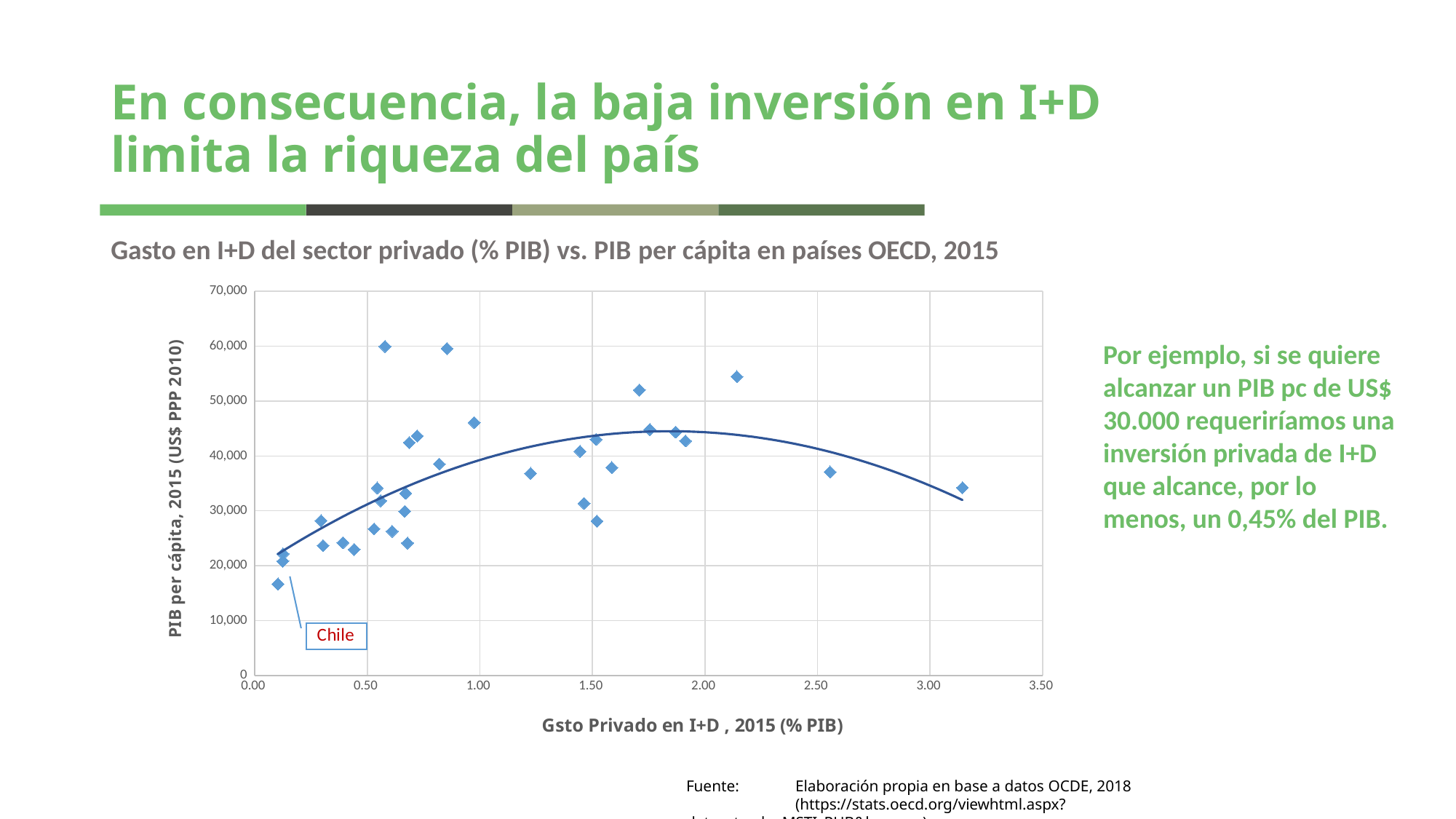
Which country is labeled on the chart? Chile Does the fitted trend line rise or fall as private R&D spending increases from 2.50 to 3.00? falls What kind of chart is shown on the slide? scatter chart What is the title of the chart? Gasto en I+D del sector privado (% PIB) vs. PIB per cápita en países OECD, 2015 Is the private R&D spending of the point furthest to the right greater or less than 3.00? greater Is the PIB per cápita value for Chile greater or less than 20,000? less Does the fitted trend line rise or fall as private R&D spending increases from 0.00 to 1.50? rises Is the PIB per cápita of the point furthest to the right greater or less than 30,000? greater